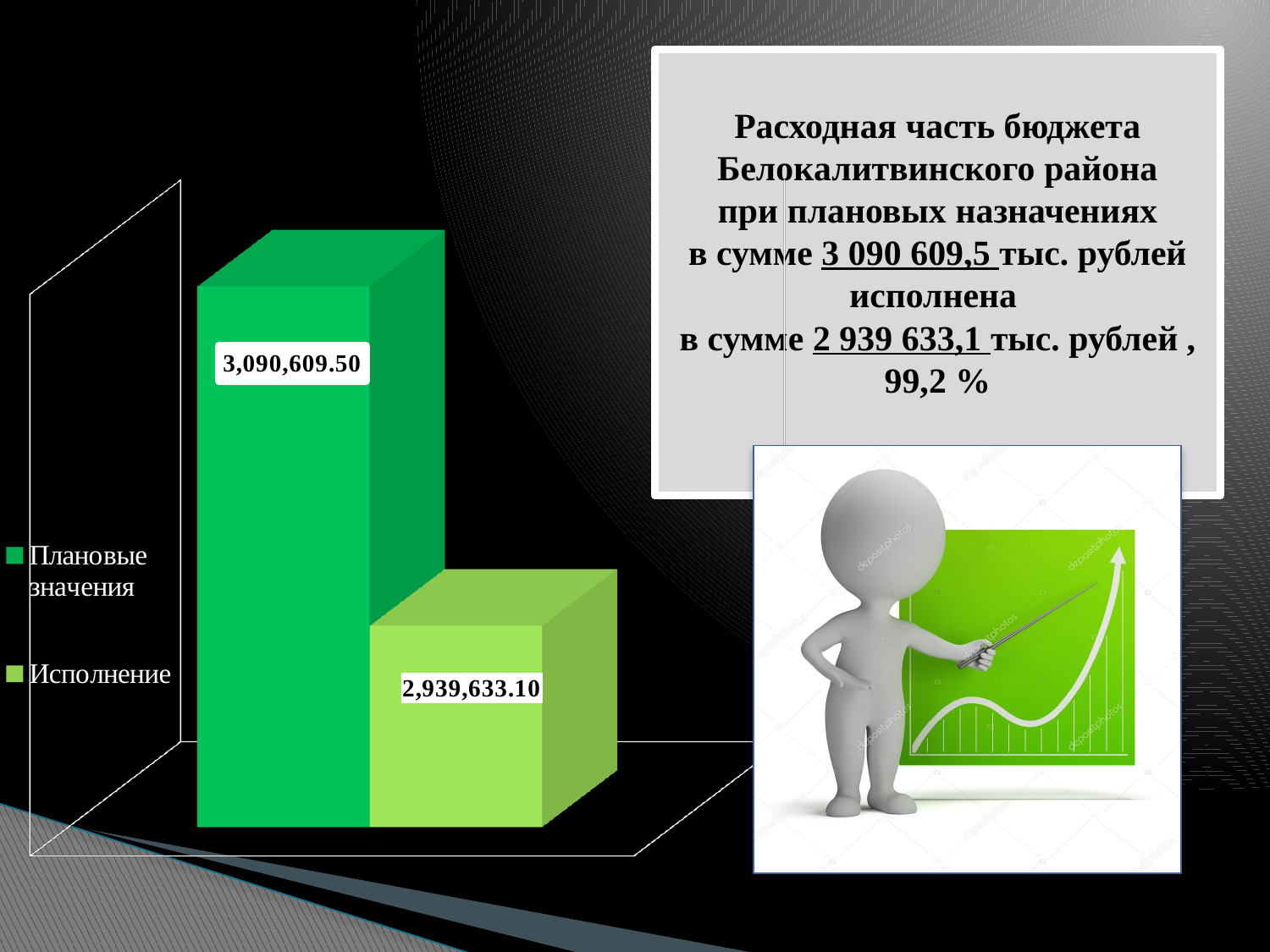
Which legend entry is shown in the lighter green colour? Исполнение What is the value shown for Исполнение? 2,939,633.10 What are the two entries in the chart legend? Плановые значения, Исполнение What is the value shown for Плановые значения? 3,090,609.50 How many series does the legend list? 2 Which bar is the shortest on the chart? Исполнение Which series has the higher value, Плановые значения or Исполнение? Плановые значения What kind of chart is shown on the slide? bar chart Which bar is the tallest on the chart? Плановые значения What is the difference between the Плановые значения value and the Исполнение value? 150,976.40 How many bars are plotted on the chart? 2